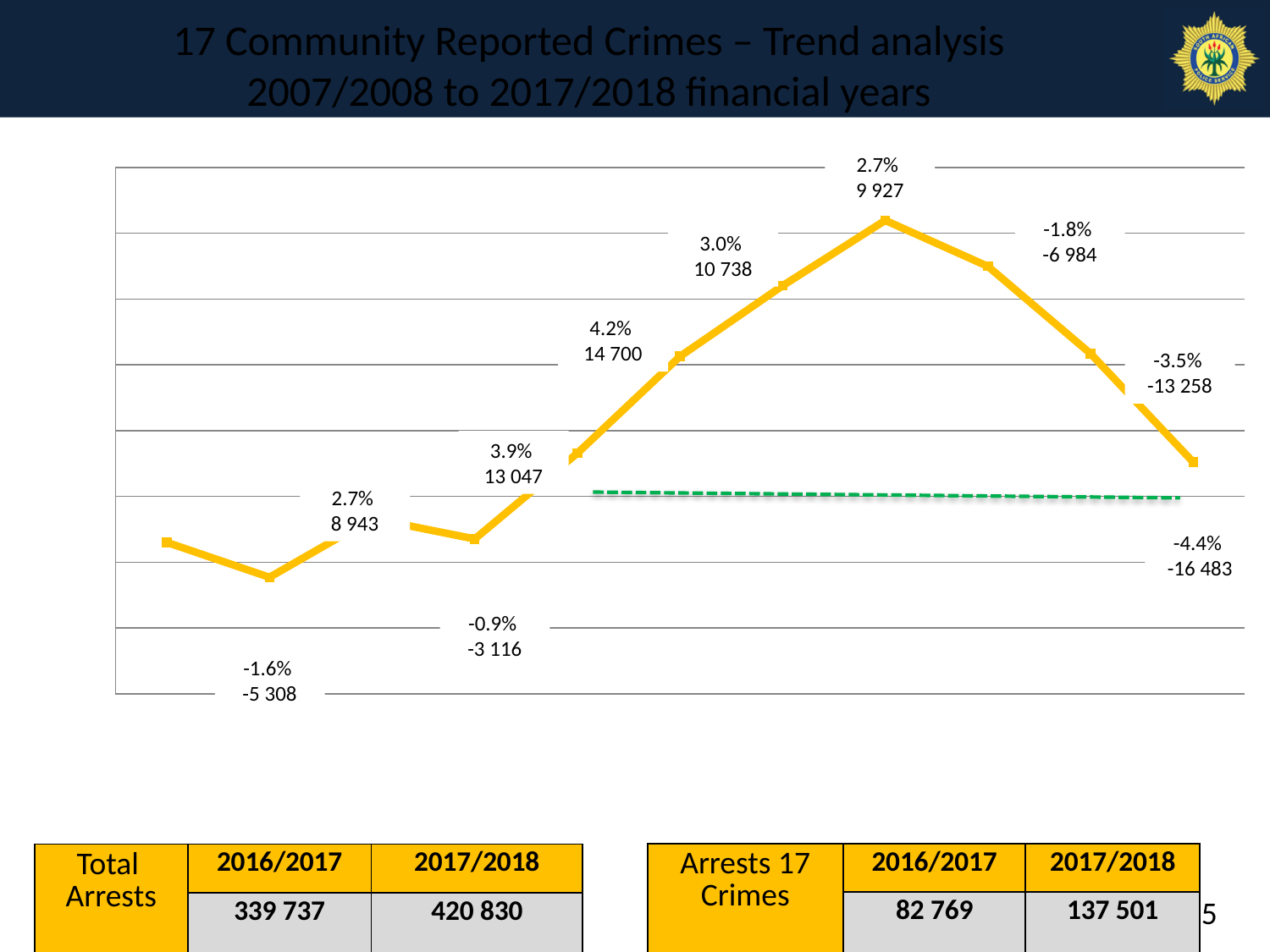
What count is labelled alongside the 4.2% change on the chart? 14 700 What is the lowest percentage change labelled on the chart? -4.4% What is the difference between the counts labelled 14 700 and 13 047? 1 653 What count is labelled at the highest point of the yellow line (the 2.7% label near the top)? 9 927 How many percentage-change labels on the chart are negative? 5 What is the highest percentage change labelled on the chart? 4.2% What colour is the dashed line drawn below the main line on the chart? green Does the yellow line rise or fall from its highest point to the right-hand end of the chart? fall What count is labelled alongside the -1.6% change on the chart? -5 308 Which is larger, the count labelled with 3.9% or the count labelled with 3.0%? 13 047 (3.9%) What kind of chart is shown on the slide? line chart What count is labelled alongside the -4.4% change on the chart? -16 483